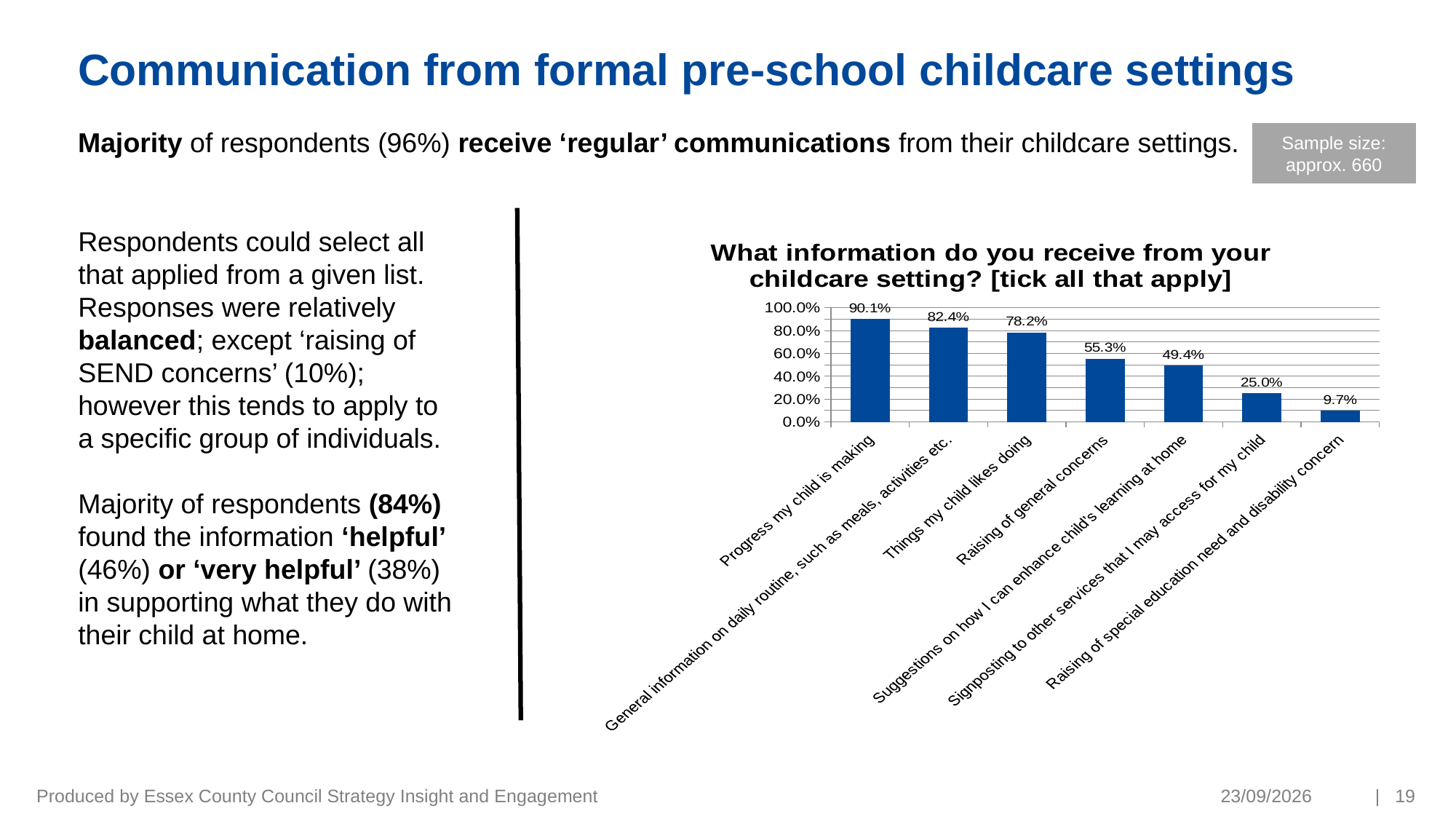
What is the difference between 'General information on daily routine, such as meals, activities etc.' and 'Raising of general concerns'? 27.1% What is the value for 'Things my child likes doing'? 78.2% Which category has the lowest value in the chart? Raising of special education need and disability concern How many categories are shown in the chart? 7 What type of chart is shown on the slide? Bar chart Is the value for 'Raising of general concerns' greater or less than 60.0%? less What percentage of respondents receive information on the progress their child is making? 90.1% Which is larger: 'Signposting to other services that I may access for my child' or 'Raising of general concerns'? Raising of general concerns What percentage of respondents receive suggestions on how they can enhance their child's learning at home? 49.4% Which category has the highest value in the chart? Progress my child is making Do the values rise or fall from left to right across the categories? Fall What is the title of the chart? What information do you receive from your childcare setting? [tick all that apply]